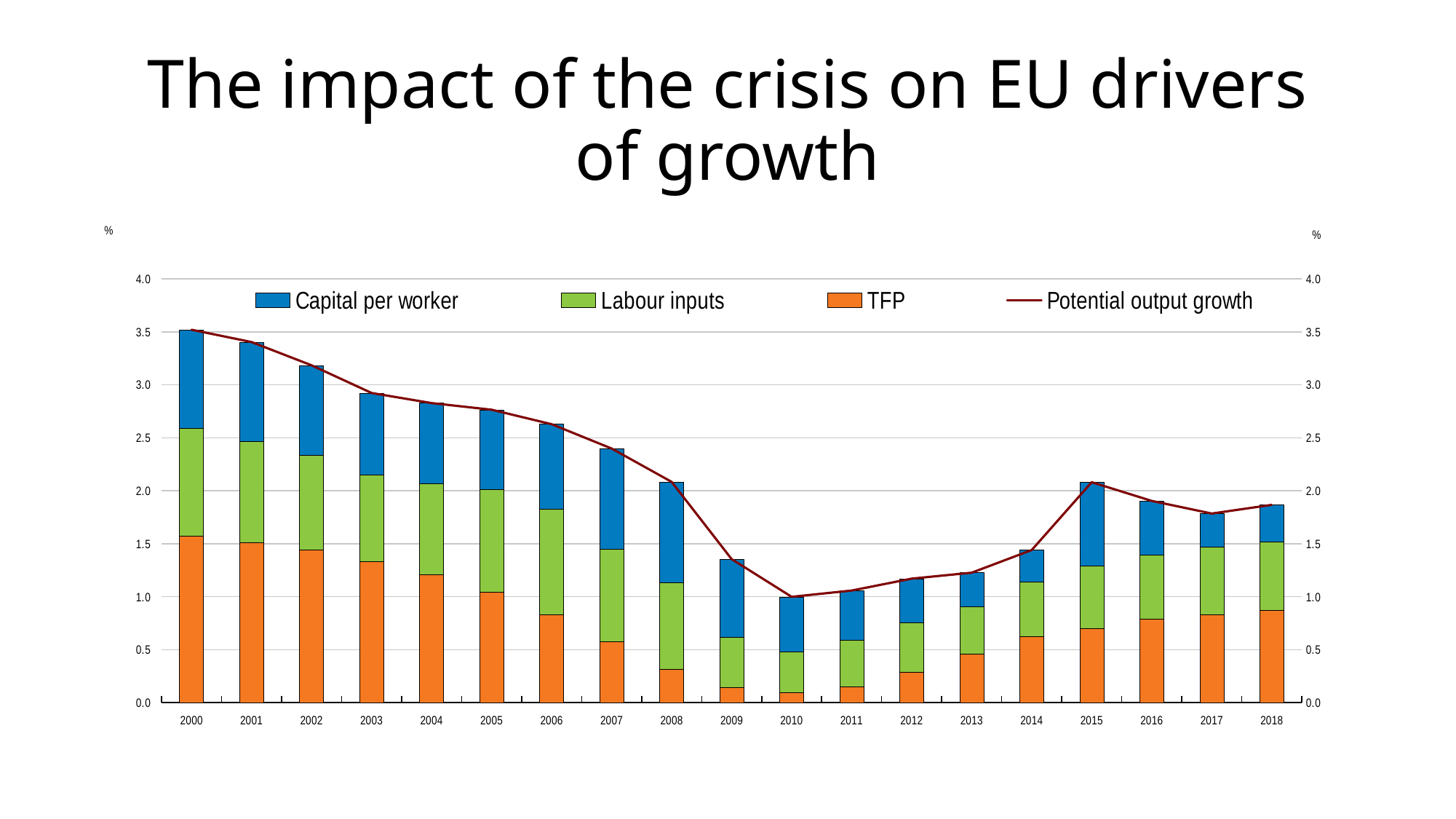
Does potential output growth rise or fall from 2000 to 2010? fall Is the potential output growth for 2000 greater or less than 3.0? greater How many years are shown on the x axis? 19 Which year has the larger TFP contribution, 2000 or 2010? 2000 Which year has the larger potential output growth, 2000 or 2018? 2000 How many series does the legend list? 4 Is the TFP contribution for 2010 greater or less than 0.5? less Which series is shown in orange? TFP What kind of chart is this? Stacked bar chart with a line Is the potential output growth for 2009 greater or less than 1.5? less In which year is potential output growth highest? 2000 In which year is potential output growth lowest? 2010